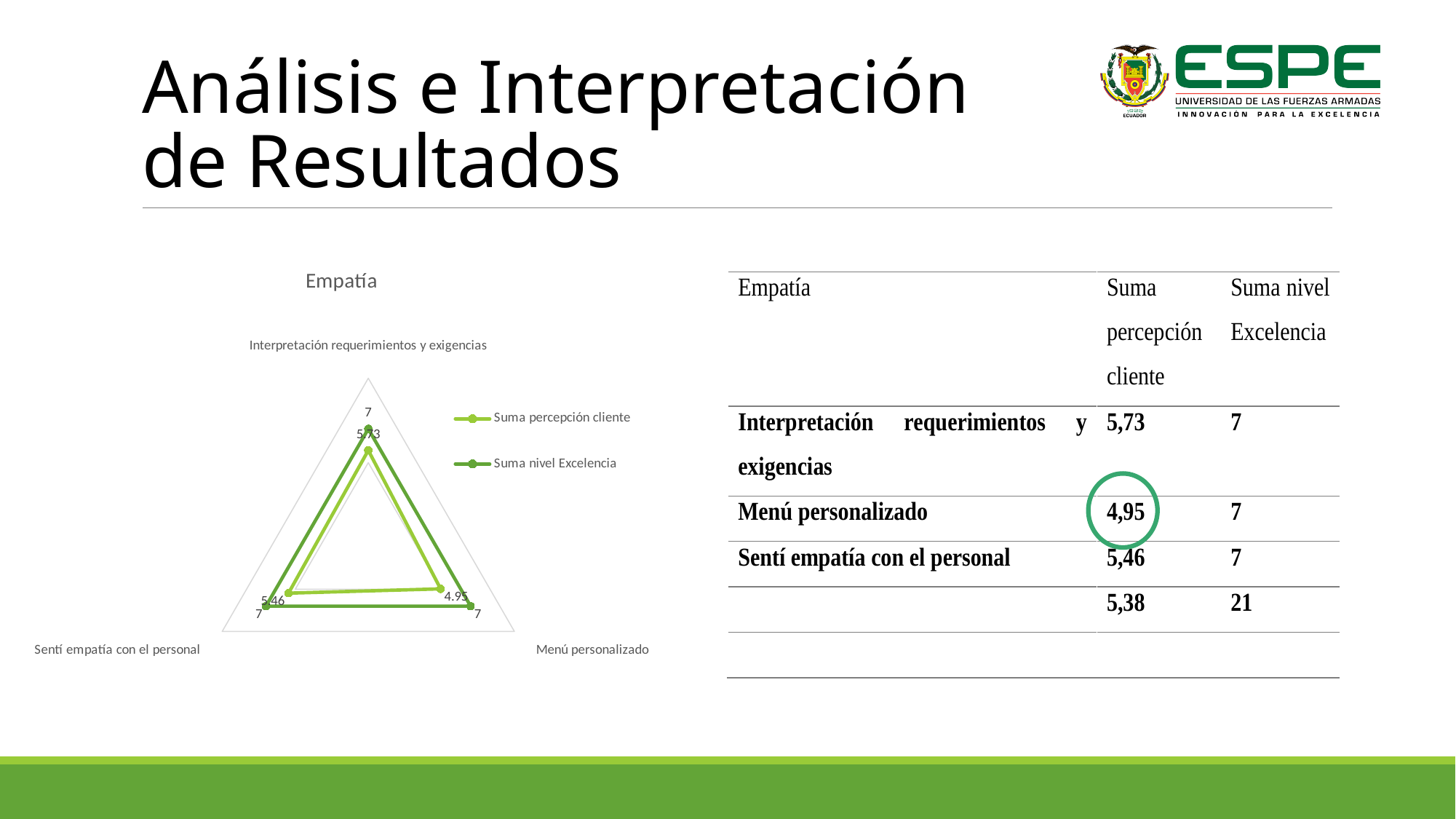
What is the Suma percepción cliente value for Sentí empatía con el personal? 5,46 What kind of chart is shown on the slide? Radar chart What is the difference between Suma nivel Excelencia and Suma percepción cliente for Menú personalizado? 2,05 How many categories are plotted on the radar chart? 3 What is the Suma percepción cliente value for Interpretación requerimientos y exigencias? 5,73 What is the Suma percepción cliente value for Menú personalizado? 4,95 Which category has the lowest Suma percepción cliente value? Menú personalizado Which category has the highest Suma percepción cliente value? Interpretación requerimientos y exigencias What is the Suma nivel Excelencia value for Menú personalizado? 7 Which is larger for Sentí empatía con el personal: Suma percepción cliente or Suma nivel Excelencia? Suma nivel Excelencia What is the title of the chart? Empatía How many series does the chart legend list? 2